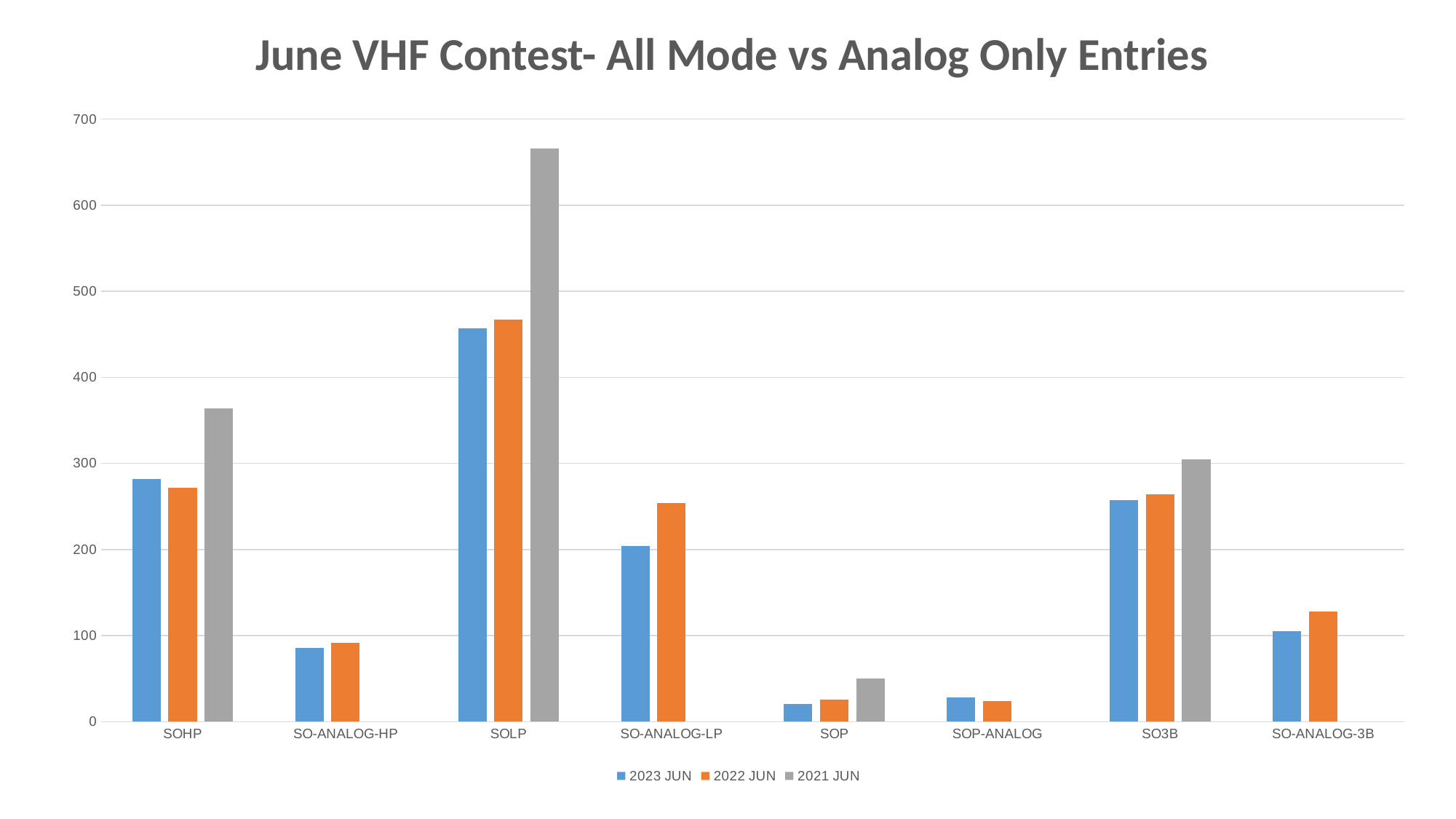
Is the 2021 JUN value for SOLP greater or less than 600? greater Is the 2023 JUN value for SO-ANALOG-HP greater or less than 100? less How many series does the legend list? 3 Which category has the highest 2021 JUN value? SOLP What is the title of the chart? June VHF Contest- All Mode vs Analog Only Entries For SO-ANALOG-LP, which is larger: the 2023 JUN value or the 2022 JUN value? 2022 JUN Which series is shown in grey? 2021 JUN Which category has the lowest 2023 JUN value? SOP How many categories are shown on the x axis? 8 For SO-ANALOG-3B, which is larger: the 2023 JUN value or the 2022 JUN value? 2022 JUN What kind of chart is shown on the slide? Bar chart Is the 2021 JUN value for SOHP greater or less than 400? less